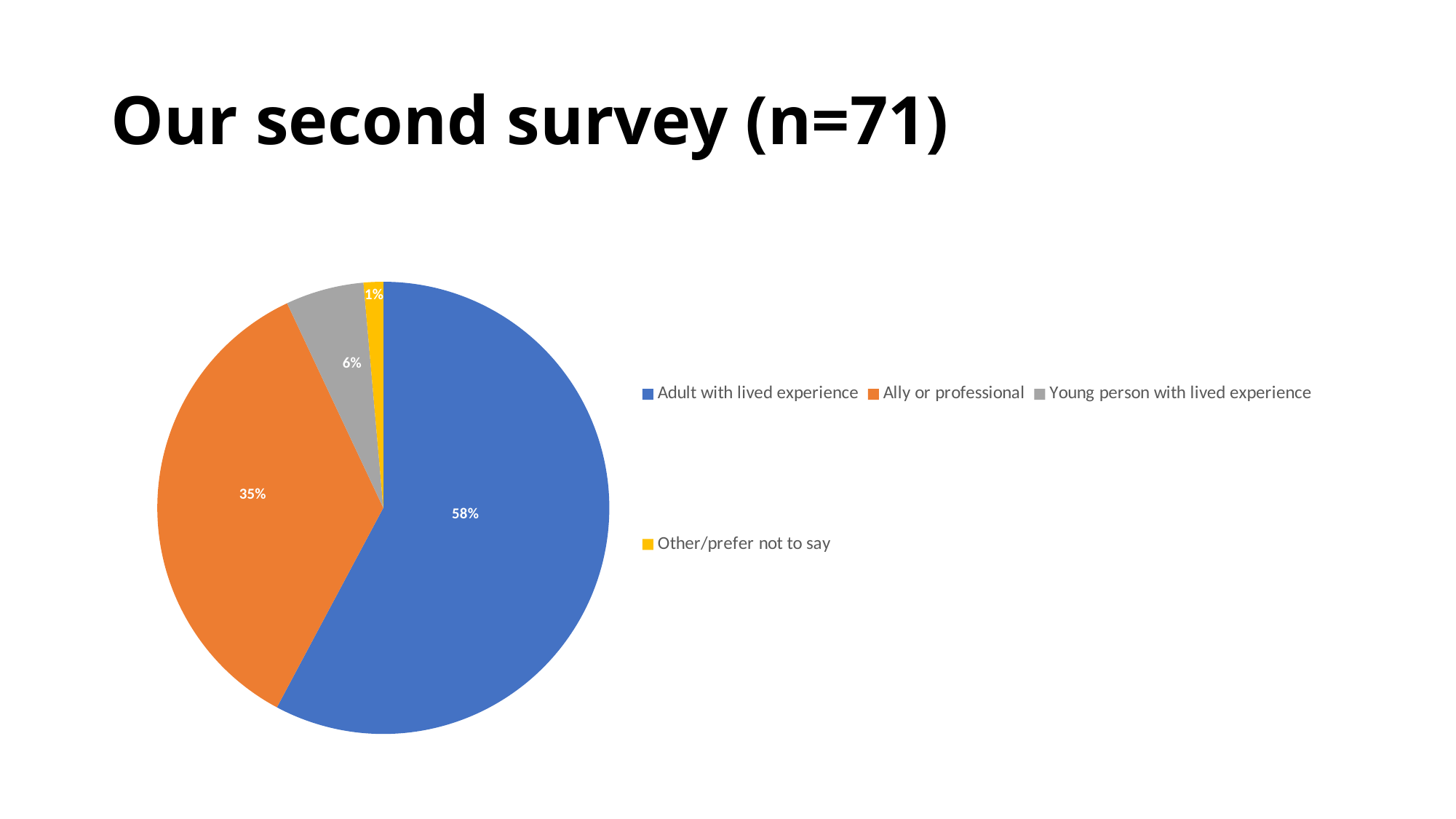
What share of the pie is 'Ally or professional'? 35% What is the title of the slide? Our second survey (n=71) What colour is the 'Ally or professional' slice? orange What kind of chart is shown on the slide? pie chart What share of the pie is 'Other/prefer not to say'? 1% Which is larger: 'Ally or professional' or 'Young person with lived experience'? Ally or professional What is the difference in percentage points between 'Adult with lived experience' and 'Ally or professional'? 23 How many categories does the pie chart have? 4 What share of the pie is 'Adult with lived experience'? 58% Which category has the smallest slice of the pie? Other/prefer not to say Which category has the largest slice of the pie? Adult with lived experience